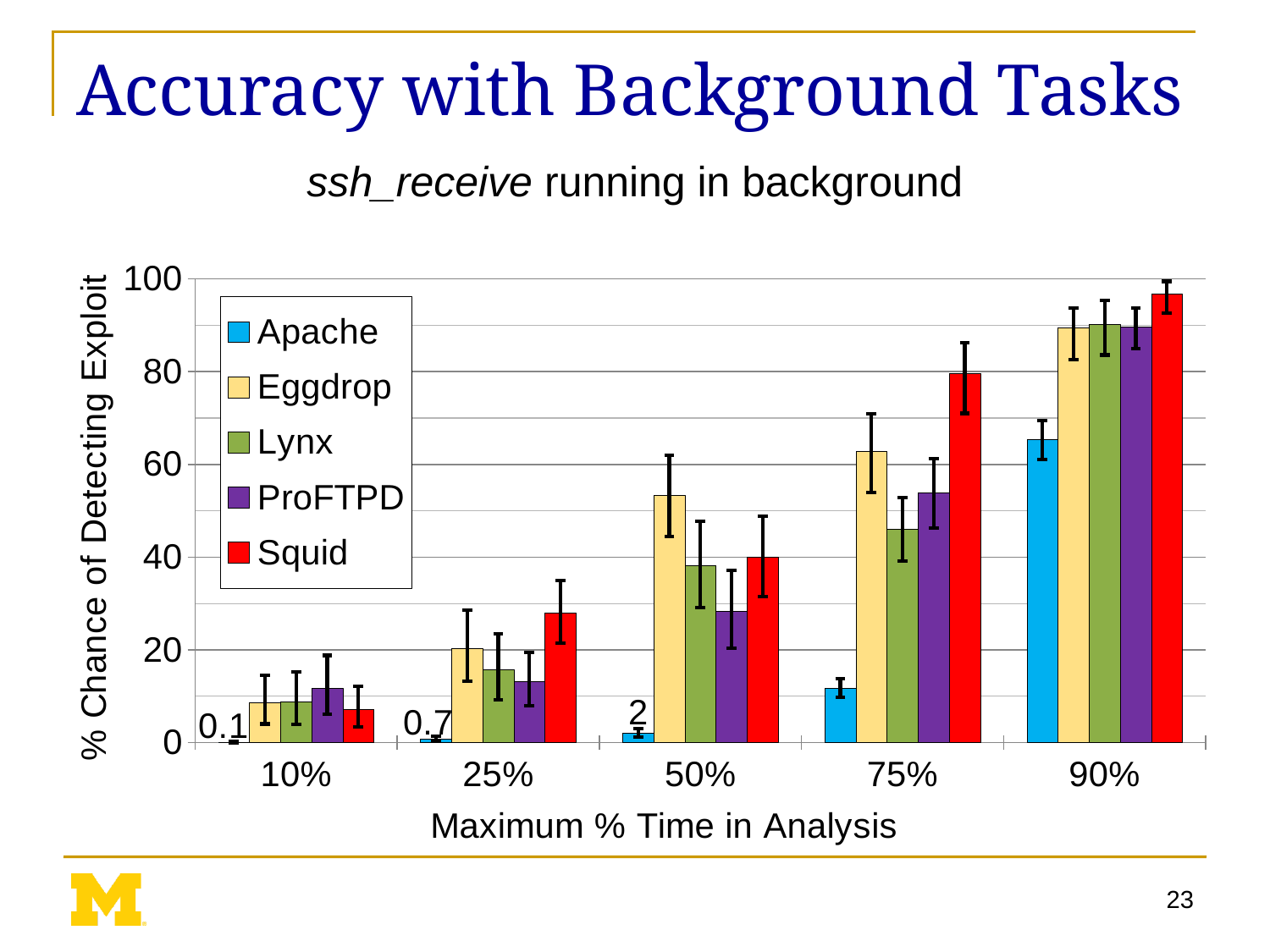
What is the value for Apache at 50% maximum time in analysis? 2 Is the value for Squid at 75% greater or less than 60? greater Do the Squid values rise or fall as maximum % time in analysis increases? rise What is the value for Apache at 10% maximum time in analysis? 0.1 Is the value for Lynx at 25% greater or less than 20? less Which program has the lowest chance of detecting the exploit at 90% maximum time in analysis? Apache What is the value for Apache at 25% maximum time in analysis? 0.7 What kind of chart is shown on the slide? bar chart How many categories are shown on the x axis? 5 How many series does the legend list? 5 Which program has the highest chance of detecting the exploit at 90% maximum time in analysis? Squid At 50% maximum time in analysis, which is larger: Eggdrop or Lynx? Eggdrop